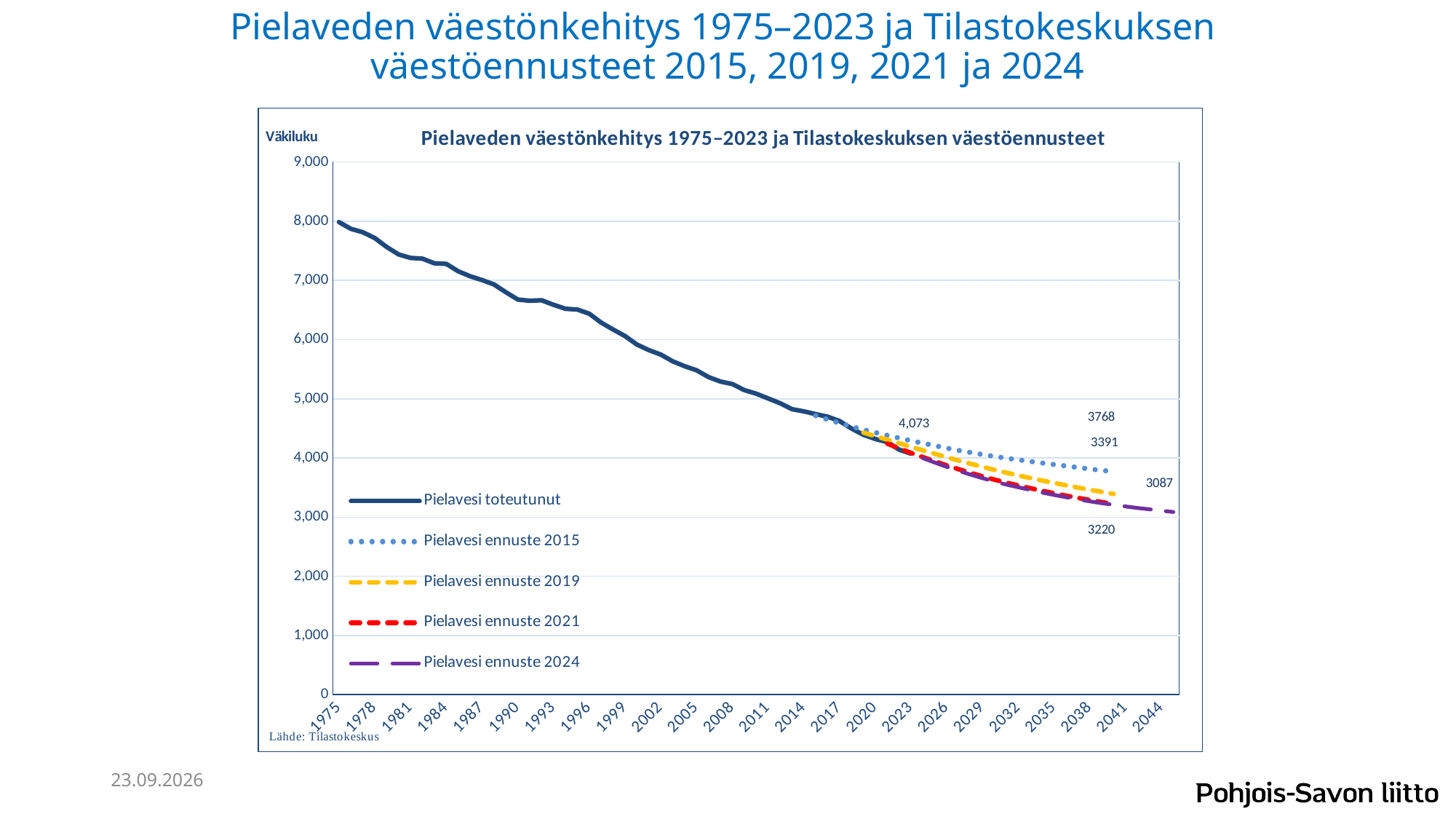
What is the final labelled value of the Pielavesi ennuste 2019 line? 3391 Which forecast line ends higher, Pielavesi ennuste 2015 or Pielavesi ennuste 2021? Pielavesi ennuste 2015 What kind of chart is shown on the slide? line chart What is the difference between the final labelled values of the Pielavesi ennuste 2015 line (3768) and the Pielavesi ennuste 2024 line (3087)? 681 How many series does the legend list? 5 Is the Pielavesi toteutunut value in 1975 greater or less than 7,000? greater What is the label on the vertical axis of the chart? Väkiluku What is the final labelled value of the Pielavesi ennuste 2024 line? 3087 Does the Pielavesi toteutunut line rise or fall from 1975 to 2023? fall What is the final labelled value of the Pielavesi ennuste 2015 line? 3768 Which forecast series ends at the highest labelled value? Pielavesi ennuste 2015 What is the final labelled value of the Pielavesi ennuste 2021 line? 3220